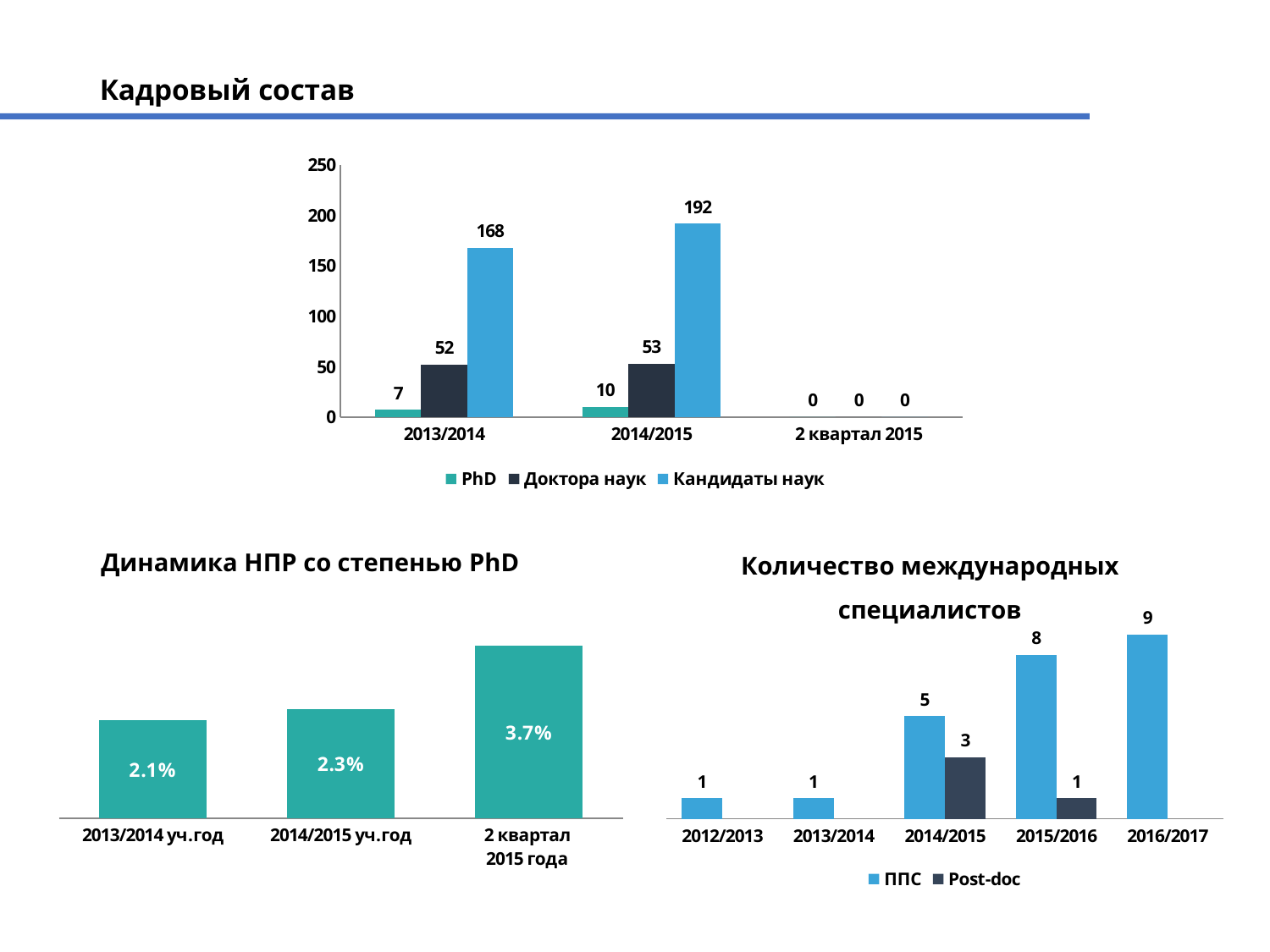
In the top chart, which series has the highest value in 2013/2014? Кандидаты наук In the top chart, what is the value for PhD in 2013/2014? 7 In the top chart, how many series does the legend list? 3 In the chart 'Динамика НПР со степенью PhD', how many categories are shown? 3 In the top chart, what is the value for Кандидаты наук in 2014/2015? 192 In the chart 'Динамика НПР со степенью PhD', do the values rise or fall from 2013/2014 уч.год to 2 квартал 2015 года? rise In the chart 'Динамика НПР со степенью PhD', what is the value for 2 квартал 2015 года? 3.7% In the top chart, what is the difference between Кандидаты наук in 2014/2015 and in 2013/2014? 24 What type of chart is 'Количество международных специалистов'? bar chart In the chart 'Количество международных специалистов', what is the value for Post-doc in 2014/2015? 3 In the chart 'Количество международных специалистов', which category has the highest ППС value? 2016/2017 In the top chart, is the value for Кандидаты наук in 2013/2014 greater or less than 150? greater